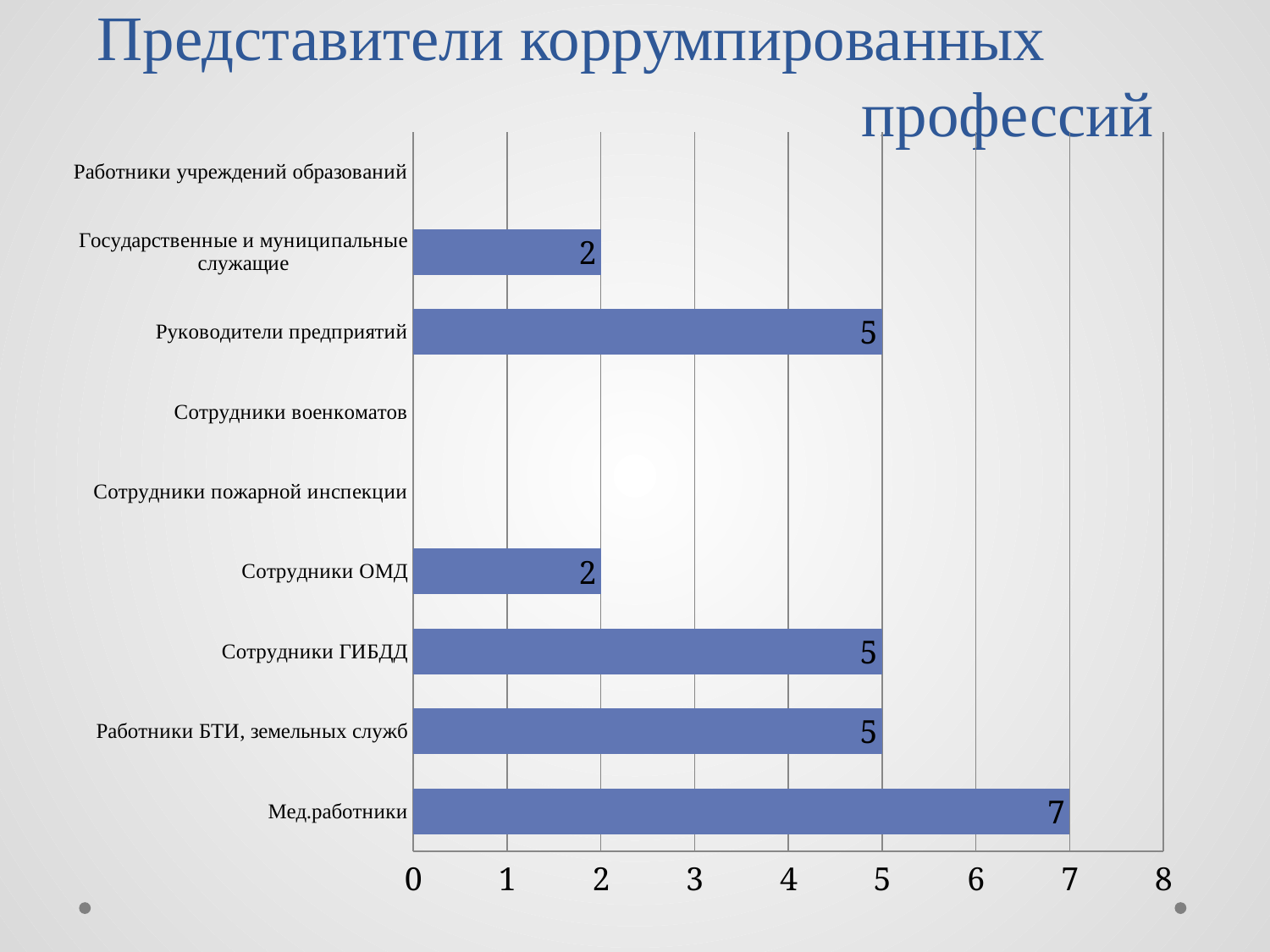
What is the value for Мед.работники? 7 Which is larger, the value for Мед.работники or the value for Руководители предприятий? Мед.работники What kind of chart is shown on the slide? bar chart What is the value for Руководители предприятий? 5 What is the difference between the values for Работники БТИ, земельных служб and Сотрудники ОМД? 3 How many categories are listed on the vertical axis? 9 What is the value for Государственные и муниципальные служащие? 2 Which category has the highest value? Мед.работники What is the difference between the values for Мед.работники and Сотрудники ГИБДД? 2 What is the value for Сотрудники ОМД? 2 Is the value for Мед.работники greater or less than 6? greater What is the title of the slide? Представители коррумпированных профессий